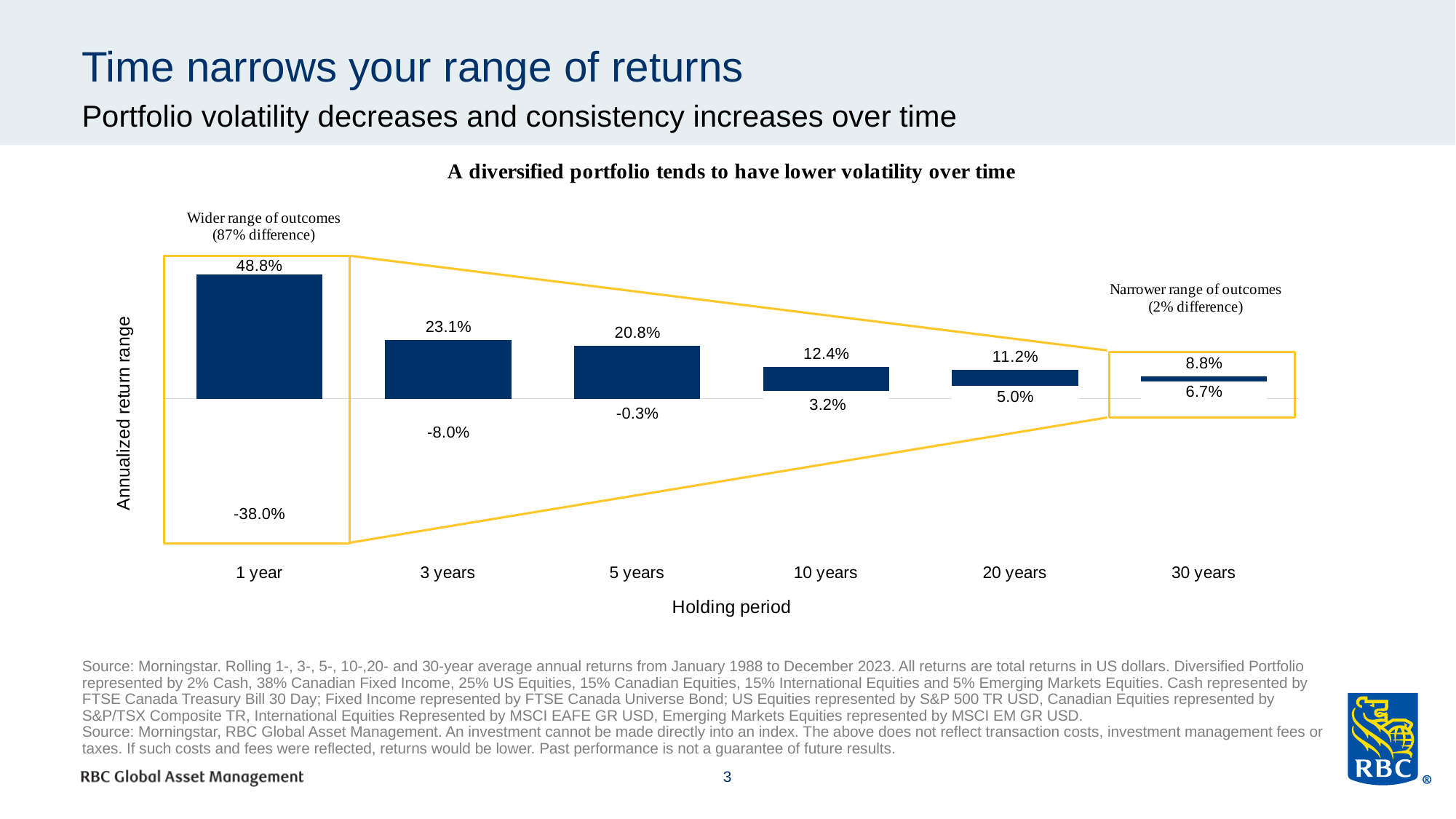
What is the lowest annualized return shown for the 1 year holding period? -38.0% Which is larger, the upper value for 5 years or the upper value for 20 years? 5 years What is the lowest annualized return shown for the 3 years holding period? -8.0% Which holding period has the lowest lower annualized return value? 1 year Which holding period has the highest upper annualized return value? 1 year What is the highest annualized return shown for the 10 years holding period? 12.4% How many holding periods are shown on the x axis? 6 Do the upper annualized return values rise or fall as the holding period increases? Fall What is the lowest annualized return shown for the 30 years holding period? 6.7% What is the highest annualized return shown for the 1 year holding period? 48.8% What kind of chart is shown on the slide? Bar chart What is the difference between the upper values for the 1 year and 3 years holding periods? 25.7%